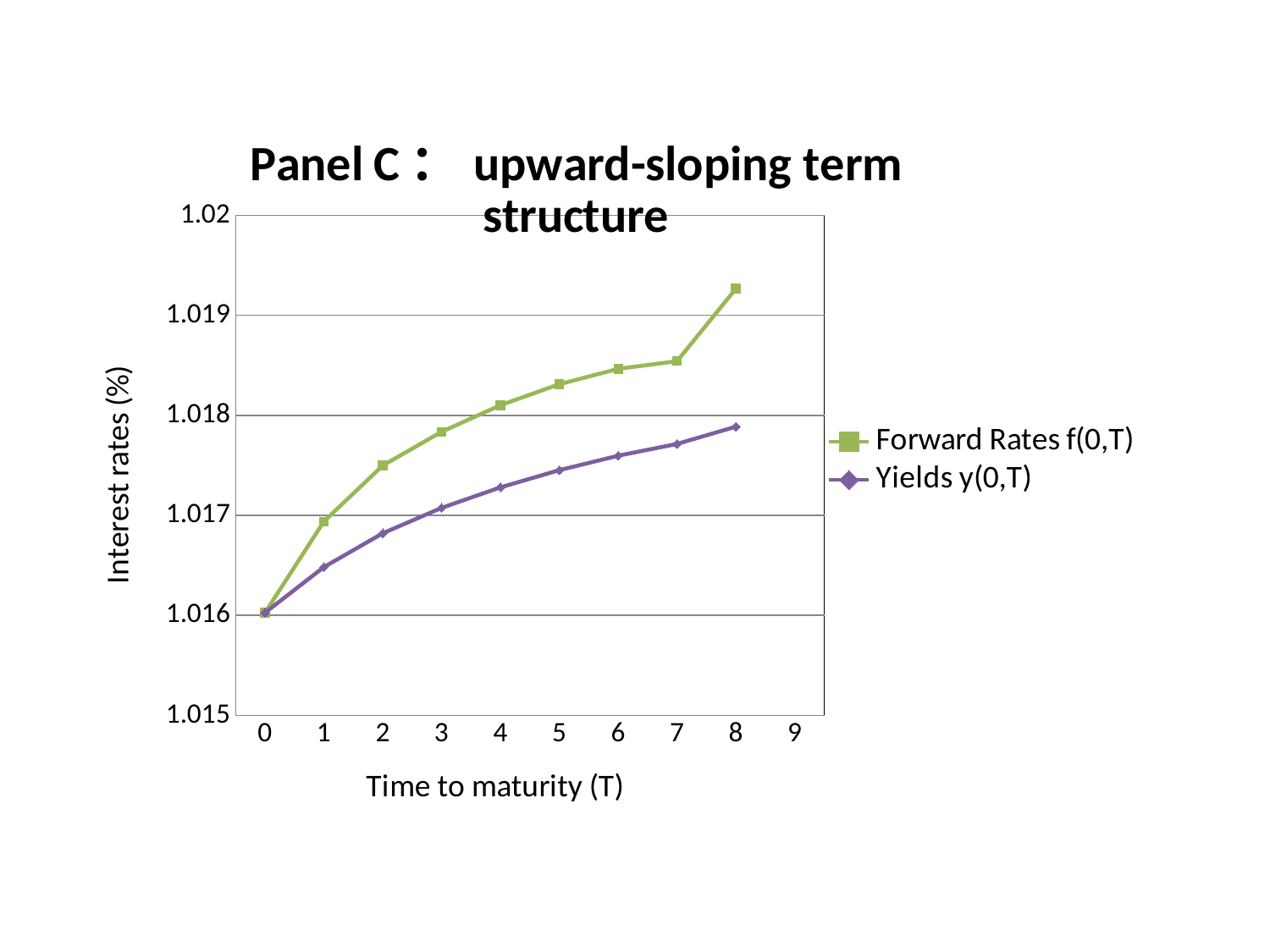
At time to maturity 4, which series has the larger value, Forward Rates f(0,T) or Yields y(0,T)? Forward Rates f(0,T) Do the Yields y(0,T) values rise or fall as time to maturity increases? rise How many series does the legend list? 2 How many data points are plotted for the Forward Rates f(0,T) series? 9 What kind of chart is shown on the slide? line chart Is the Forward Rates f(0,T) value at time to maturity 8 greater or less than 1.019? greater At which time to maturity is the Yields y(0,T) value lowest? 0 At which time to maturity is the Forward Rates f(0,T) value highest? 8 What is the label of the y axis? Interest rates (%) Is the Forward Rates f(0,T) value at time to maturity 2 greater or less than 1.017? greater Is the Yields y(0,T) value at time to maturity 8 greater or less than 1.018? less